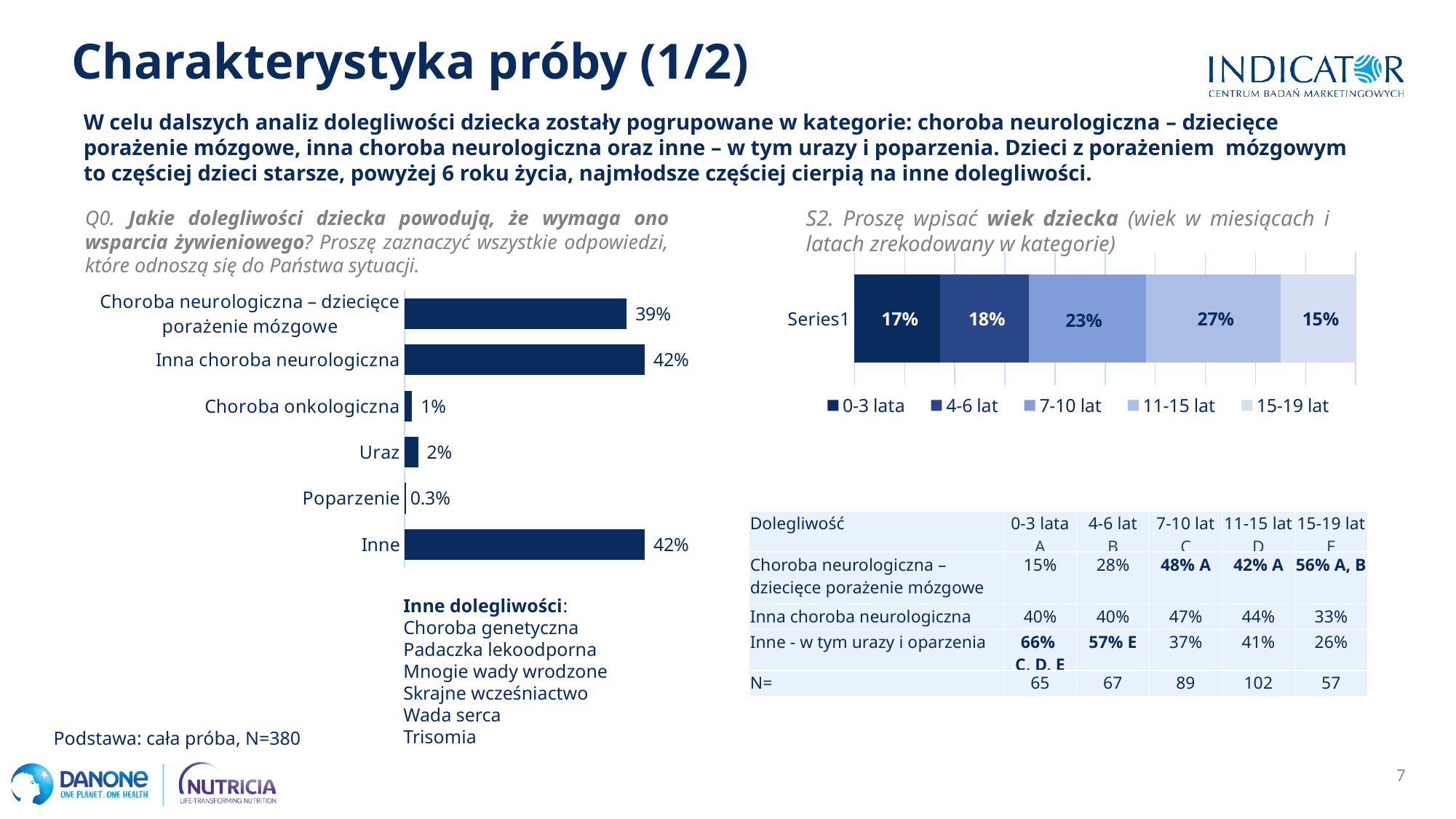
What kind of chart is the left chart (Q0)? Bar chart In the right chart (S2), which age group has the smallest share? 15-19 lat In the right chart (S2), what is the total of all segments in the stacked bar? 100% In the left chart (Q0), which category has the lowest value? Poparzenie How many categories are shown in the left chart (Q0)? 6 How many series does the legend of the right chart (S2) list? 5 In the left chart (Q0), what is the difference between the values for Inna choroba neurologiczna and Choroba neurologiczna – dziecięce porażenie mózgowe? 3% In the left chart (Q0), which is larger: the value for Uraz or the value for Choroba onkologiczna? Uraz In the right chart (S2), what is the value for the 11-15 lat segment? 27% In the left chart (Q0), what is the value for Choroba onkologiczna? 1% In the left chart (Q0), what is the value for Choroba neurologiczna – dziecięce porażenie mózgowe? 39% In the right chart (S2), which age group has the largest share? 11-15 lat